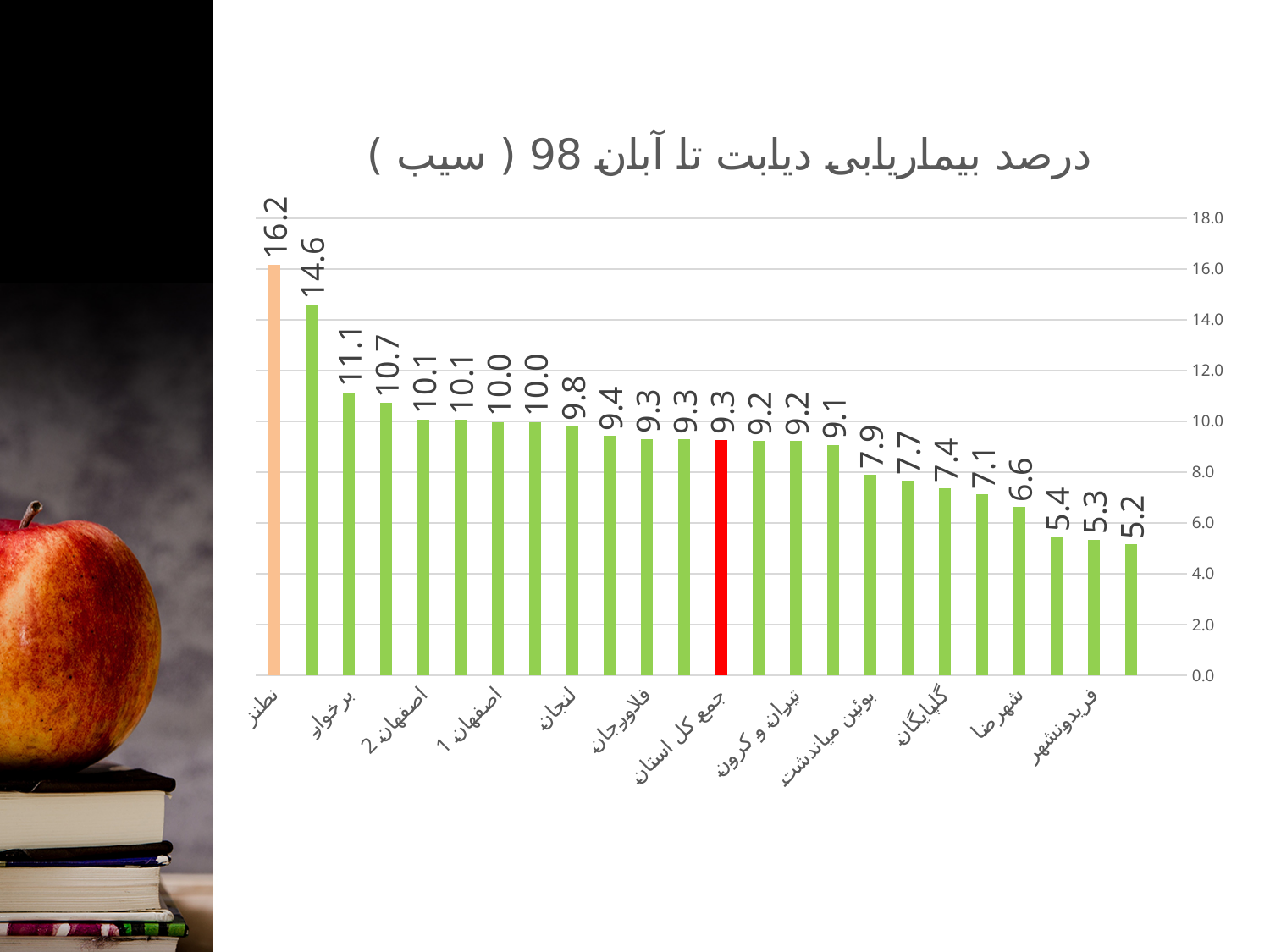
What is the value shown for نطنز? 16.2 Do the values rise or fall from left to right along the x axis? fall What colour is the bar for جمع کل استان? red What is the value shown for جمع کل استان? 9.3 What is the lowest value plotted on the chart? 5.2 What is the value shown for فریدونشهر? 5.3 Which category has the highest value? نطنز What is the difference between the value for نطنز and the value for جمع کل استان? 6.9 What is the value shown for برخوار? 11.1 What kind of chart is shown on the slide? bar chart Which is larger, the value for نطنز or the value for برخوار? نطنز How many bars are plotted on the chart? 24